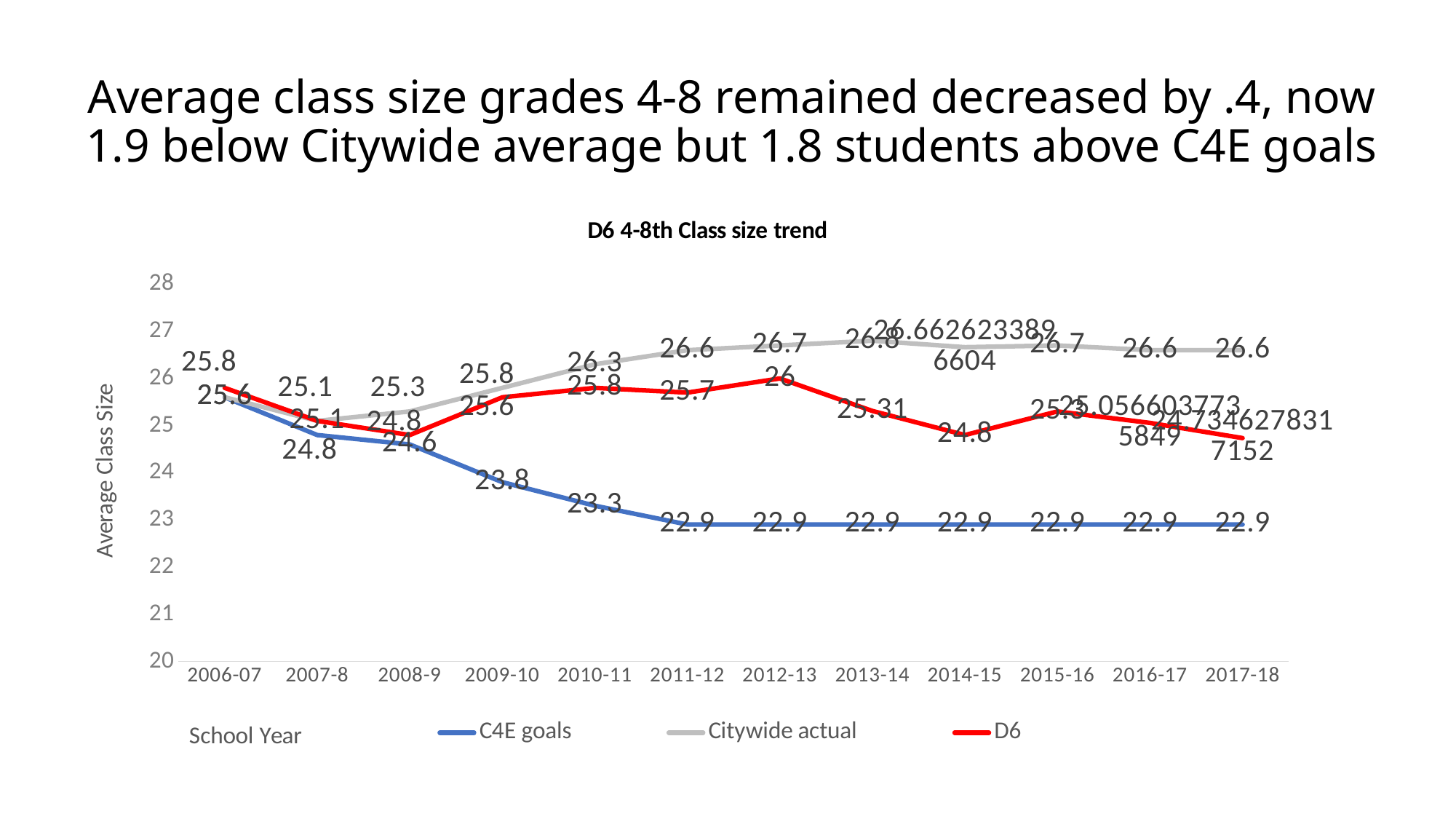
What is the C4E goals value for 2017-18? 22.9 In which school year is the C4E goals value highest? 2006-07 What type of chart is shown on the slide? line chart How many series does the legend list? 3 What is the D6 value for 2011-12? 25.7 In 2011-12, which is larger: the Citywide actual value or the D6 value? Citywide actual Is the D6 value for 2014-15 greater or less than 25? less What is the difference between the Citywide actual value and the C4E goals value in 2012-13? 3.8 How many school years are plotted on the x axis? 12 What is the C4E goals value for 2009-10? 23.8 What is the Citywide actual value for 2012-13? 26.7 Do the C4E goals values rise or fall from 2006-07 to 2011-12? fall